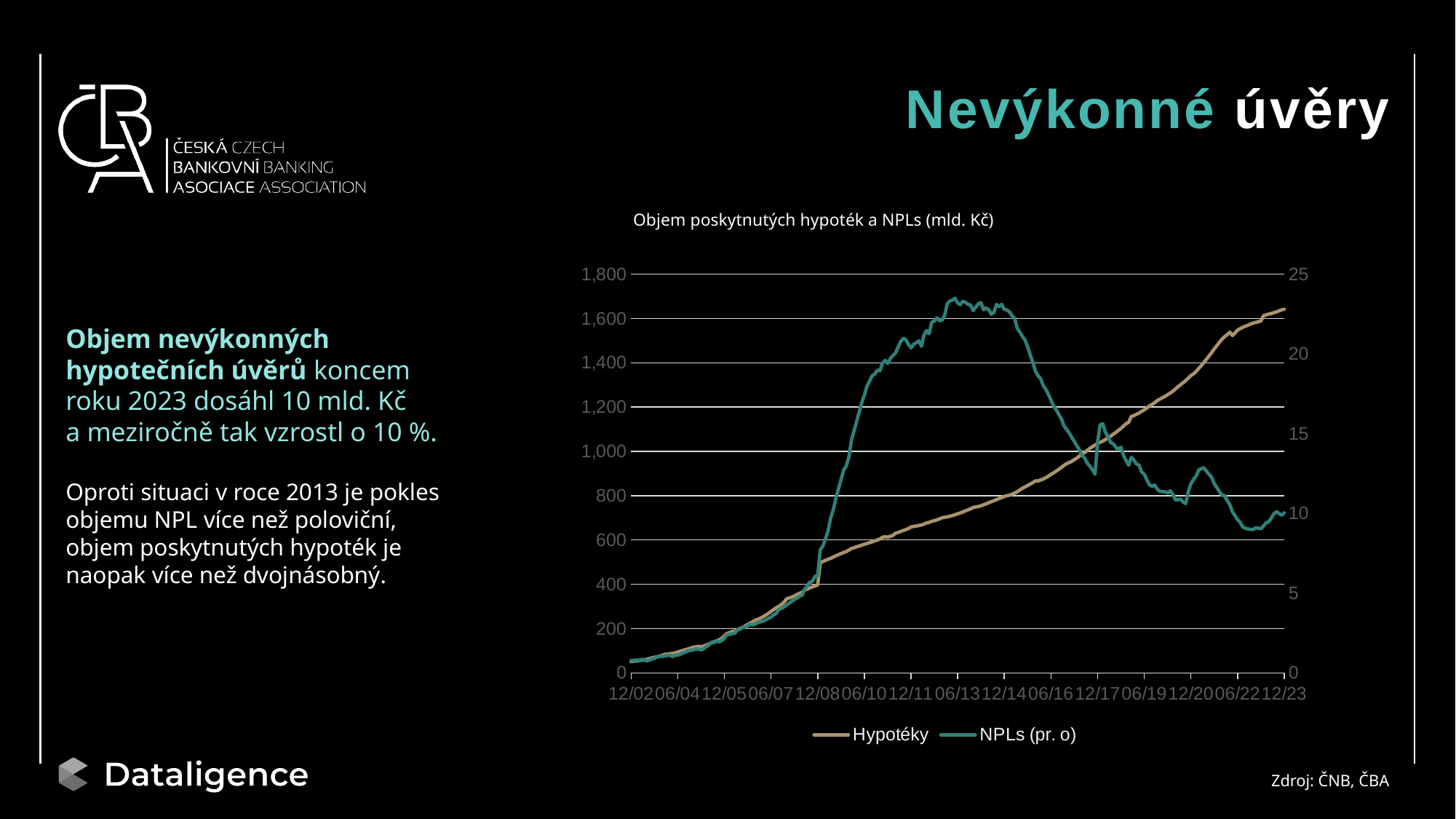
How many series does the chart legend list? 2 Is the peak value of NPLs (pr. o) on the right axis greater or less than 20? greater What kind of chart is shown on the slide? line chart Does the Hypotéky series rise or fall overall from 12/02 to 12/23? rise Is the value of Hypotéky at 12/23 greater or less than 1,400? greater Around which x-axis label does the NPLs (pr. o) series reach its highest value? 06/13 Is the value of Hypotéky at 06/13 greater or less than 600? greater What is the title of the chart? Objem poskytnutých hypoték a NPLs (mld. Kč) How many labels are shown on the x axis of the chart? 15 Does the NPLs (pr. o) series rise or fall between 06/13 and 12/23? fall What are the two series named in the chart legend? Hypotéky and NPLs (pr. o)